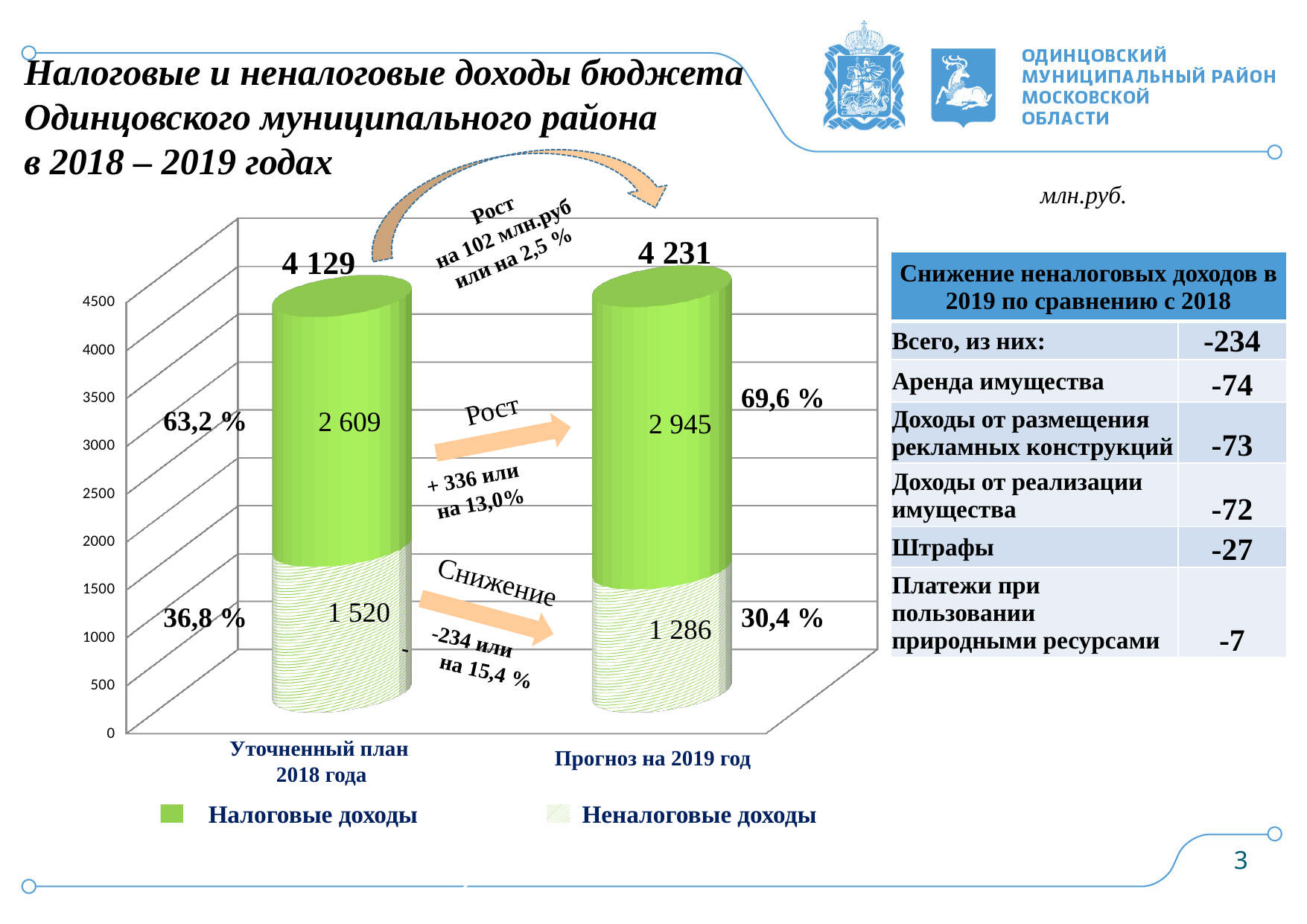
Do the Налоговые доходы values rise or fall from 2018 to 2019? rise What is the total of the stacked bar for Прогноз на 2019 год? 4 231 What is the value of Неналоговые доходы for Уточненный план 2018 года? 1 520 What is the value of Налоговые доходы for Уточненный план 2018 года? 2 609 What is the total of the stacked bar for Уточненный план 2018 года? 4 129 How many series does the chart legend list? 2 What is the difference in Налоговые доходы between Прогноз на 2019 год and Уточненный план 2018 года? 336 How many categories are shown on the x axis of the chart? 2 What is the value of Неналоговые доходы for Прогноз на 2019 год? 1 286 Which category has the higher value for Неналоговые доходы, Уточненный план 2018 года or Прогноз на 2019 год? Уточненный план 2018 года What kind of chart is shown on the slide? stacked bar chart What share of the 2019 forecast total do Налоговые доходы make up, as labelled on the chart? 69,6 %